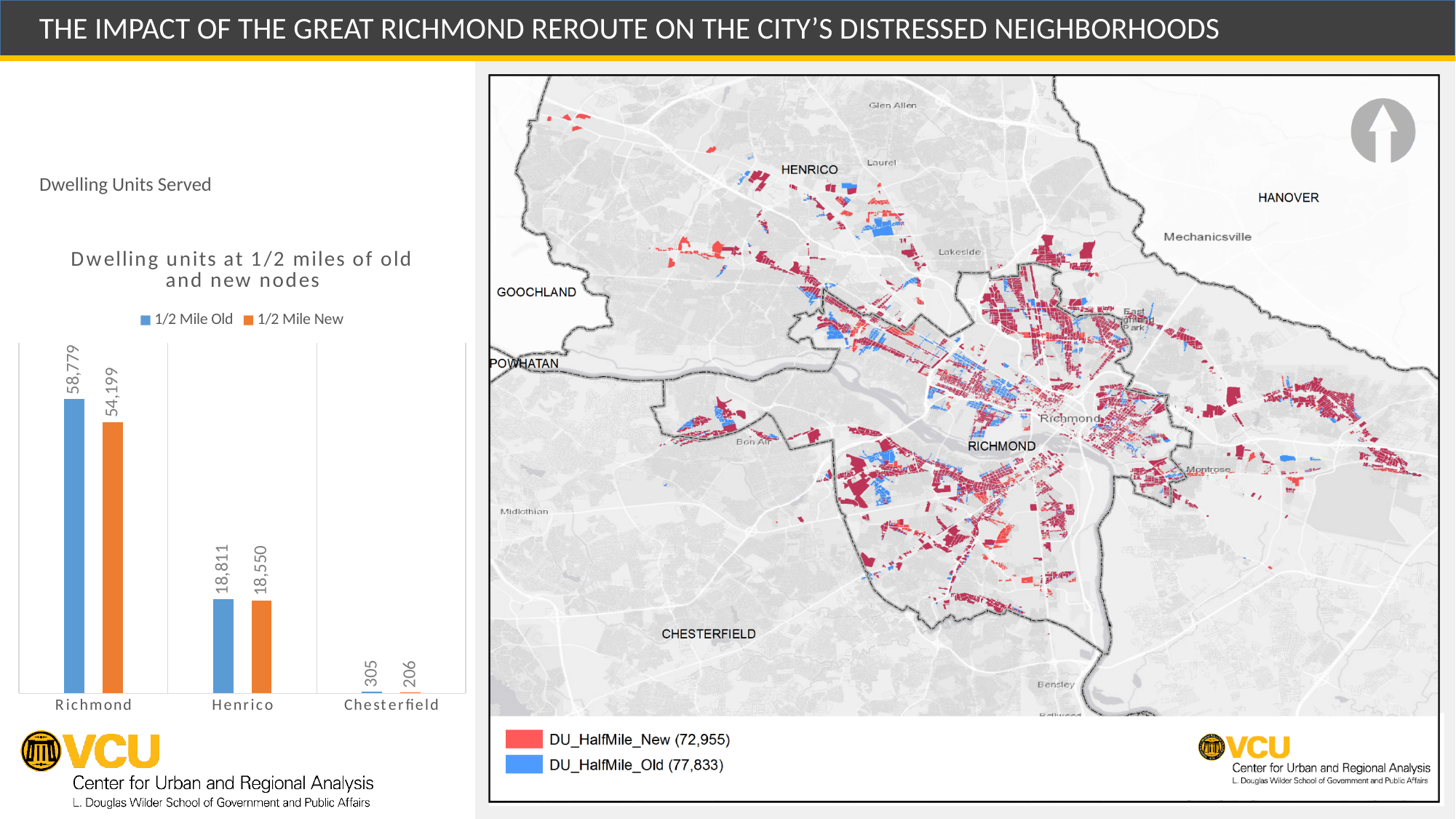
How many series does the legend of the bar chart list? 2 What is the value for 1/2 Mile Old in Richmond? 58,779 What is the difference between the 1/2 Mile Old and 1/2 Mile New values for Richmond? 4,580 What is the title of the bar chart? Dwelling units at 1/2 miles of old and new nodes What is the value for 1/2 Mile New in Chesterfield? 206 What kind of chart is used to show dwelling units at 1/2 miles of old and new nodes? Bar chart Which category has the highest value for 1/2 Mile New? Richmond What is the value for 1/2 Mile Old in Chesterfield? 305 Which category has the lowest value for 1/2 Mile Old? Chesterfield Which is larger for Henrico, the 1/2 Mile Old value or the 1/2 Mile New value? 1/2 Mile Old How many categories are shown on the x axis of the bar chart? 3 What is the value for 1/2 Mile New in Henrico? 18,550